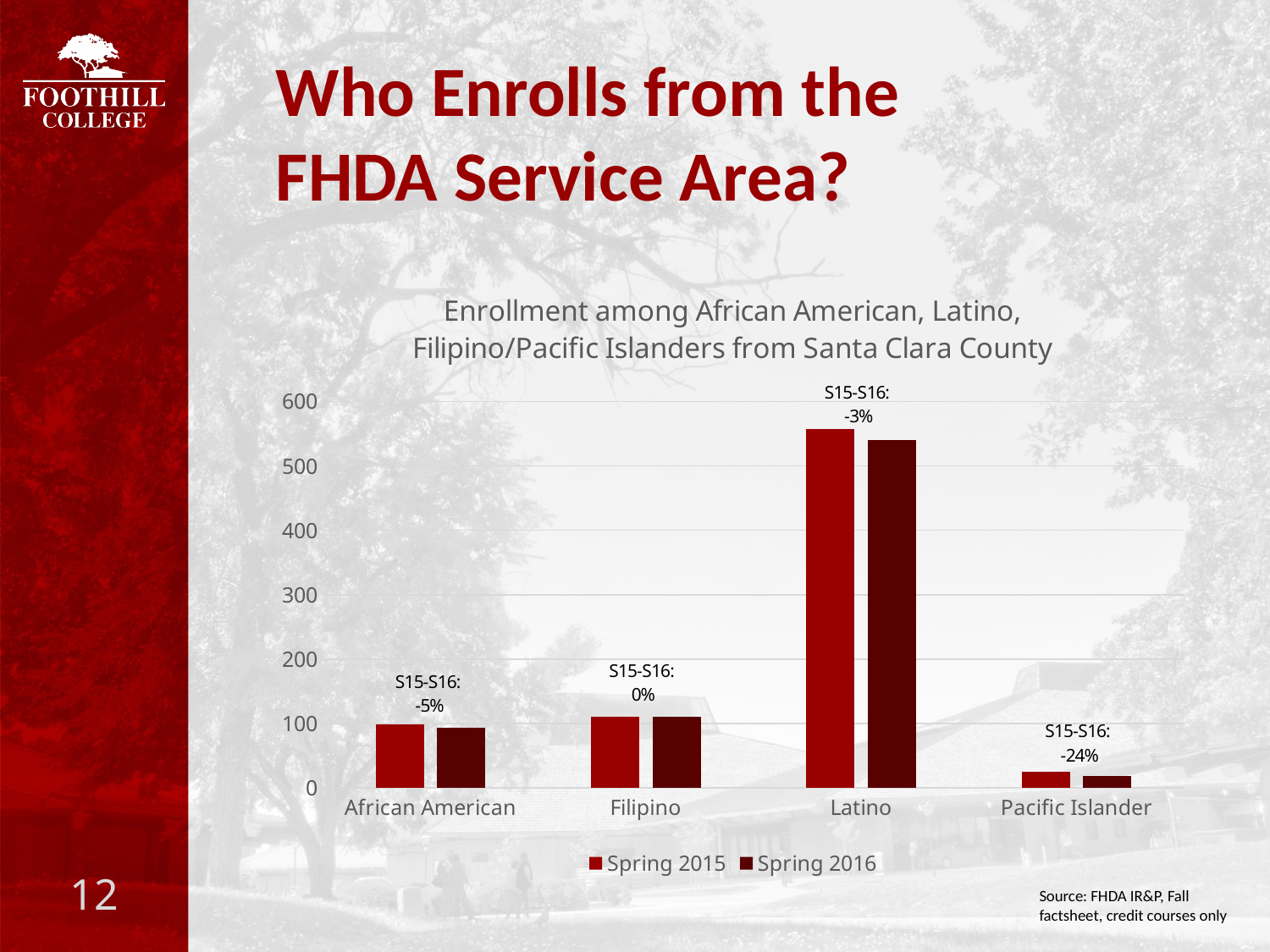
What S15-S16 change is labelled for Filipino? 0% How many categories are shown on the x axis? 4 What kind of chart is shown on the slide? bar chart Is the Spring 2015 value for Latino greater or less than 500? greater What S15-S16 change is labelled for Pacific Islander? -24% How many series does the legend list? 2 Which is larger, the Spring 2015 value for Latino or the Spring 2015 value for Filipino? Latino What S15-S16 change is labelled for Latino? -3% Is the Spring 2016 value for Pacific Islander greater or less than 100? less Which category has the highest enrollment? Latino What S15-S16 change is labelled for African American? -5% Which category has the lowest enrollment? Pacific Islander